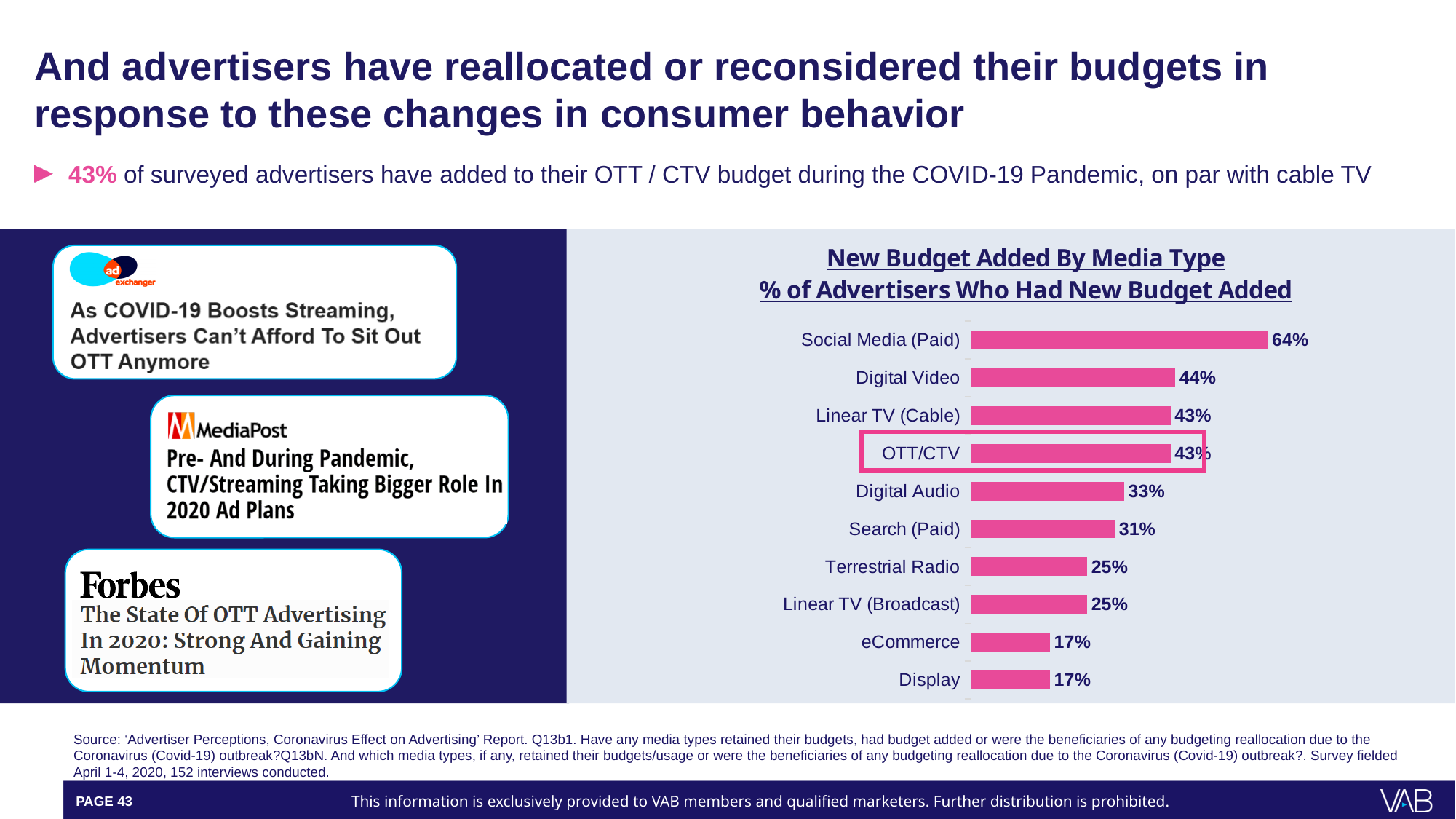
What is the difference in percentage points between Social Media (Paid) and Digital Video? 20 What kind of chart is used to show New Budget Added By Media Type? Bar chart What percentage is shown for OTT/CTV? 43% Which media type is highlighted with a box in the chart? OTT/CTV Which is larger, the value for Digital Video or the value for Terrestrial Radio? Digital Video Which media type has the highest percentage of advertisers who had new budget added? Social Media (Paid) How many media types are shown in the chart? 10 What is the value shown for Digital Audio? 33% What is the difference between the values for Digital Audio and Search (Paid)? 2 Which two media types share the lowest value of 17%? eCommerce and Display What is the value shown for Linear TV (Broadcast)? 25% What percentage of advertisers had new budget added for Social Media (Paid)? 64%